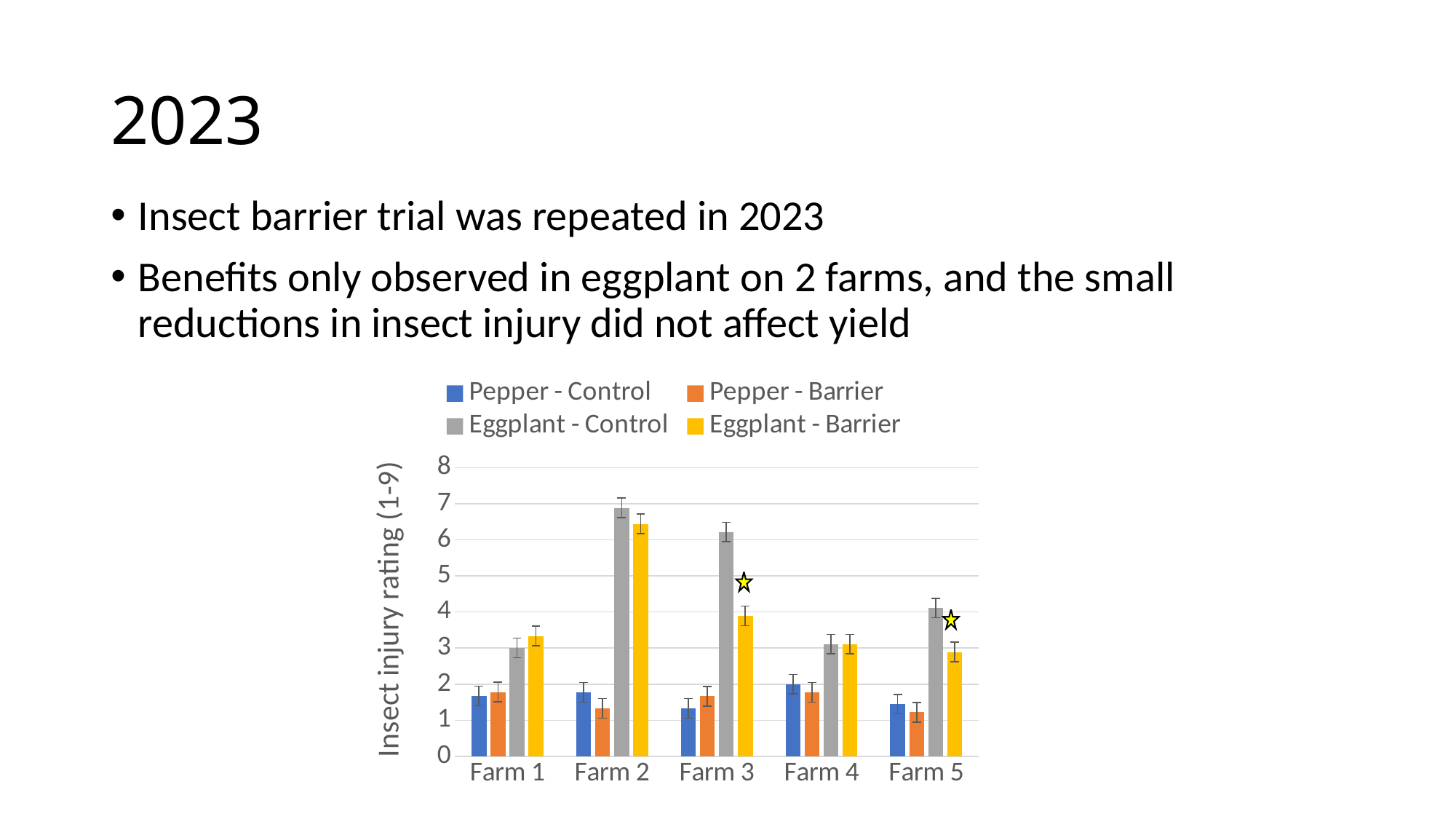
What kind of chart is shown on the slide? bar chart How many series does the legend list? 4 How many farms are shown on the x axis? 5 Is the Eggplant - Control value for Farm 5 greater or less than 3? greater At Farm 2, which is larger: Pepper - Control or Eggplant - Control? Eggplant - Control What is the label on the y axis of the chart? Insect injury rating (1-9) Is the Eggplant - Barrier value for Farm 3 greater or less than 5? less Is the Pepper - Control value for Farm 4 greater or less than 3? less At Farm 3, which is larger: Eggplant - Control or Eggplant - Barrier? Eggplant - Control Which series has the highest value at Farm 5? Eggplant - Control Which farm has the highest Eggplant - Control insect injury rating? Farm 2